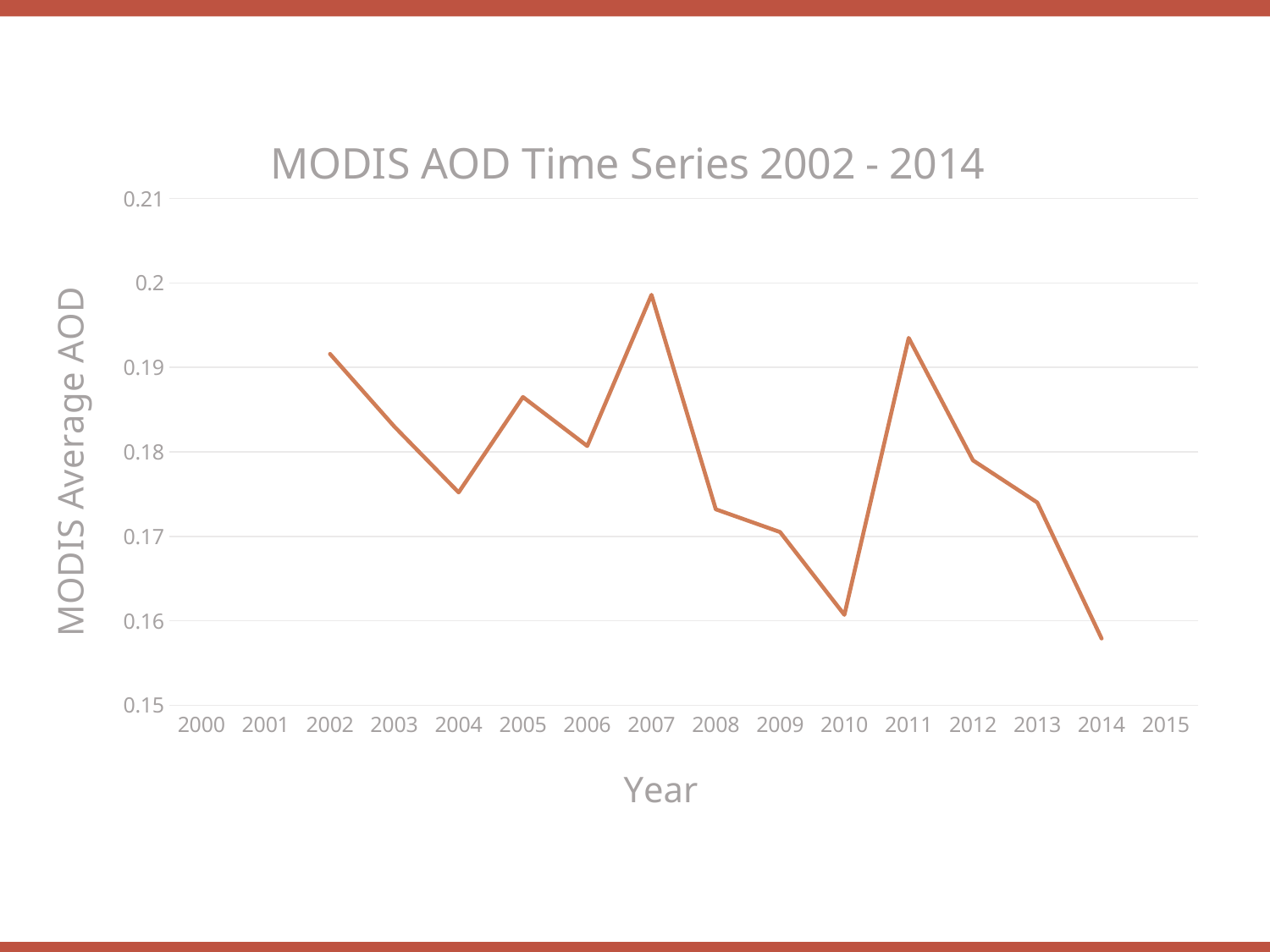
What is the title of the chart? MODIS AOD Time Series 2002 - 2014 In which year is the MODIS Average AOD lowest? 2014 Is the value for 2012 greater or less than 0.18? less Which year has the larger MODIS Average AOD, 2007 or 2011? 2007 How many years have a plotted data point on the line? 13 Is the value for 2004 greater or less than 0.18? less Overall, does the MODIS Average AOD rise or fall from 2002 to 2014? fall What kind of chart is shown on the slide? line chart In which year is the MODIS Average AOD highest? 2007 Is the value for 2002 greater or less than 0.19? greater What is the label of the vertical axis? MODIS Average AOD